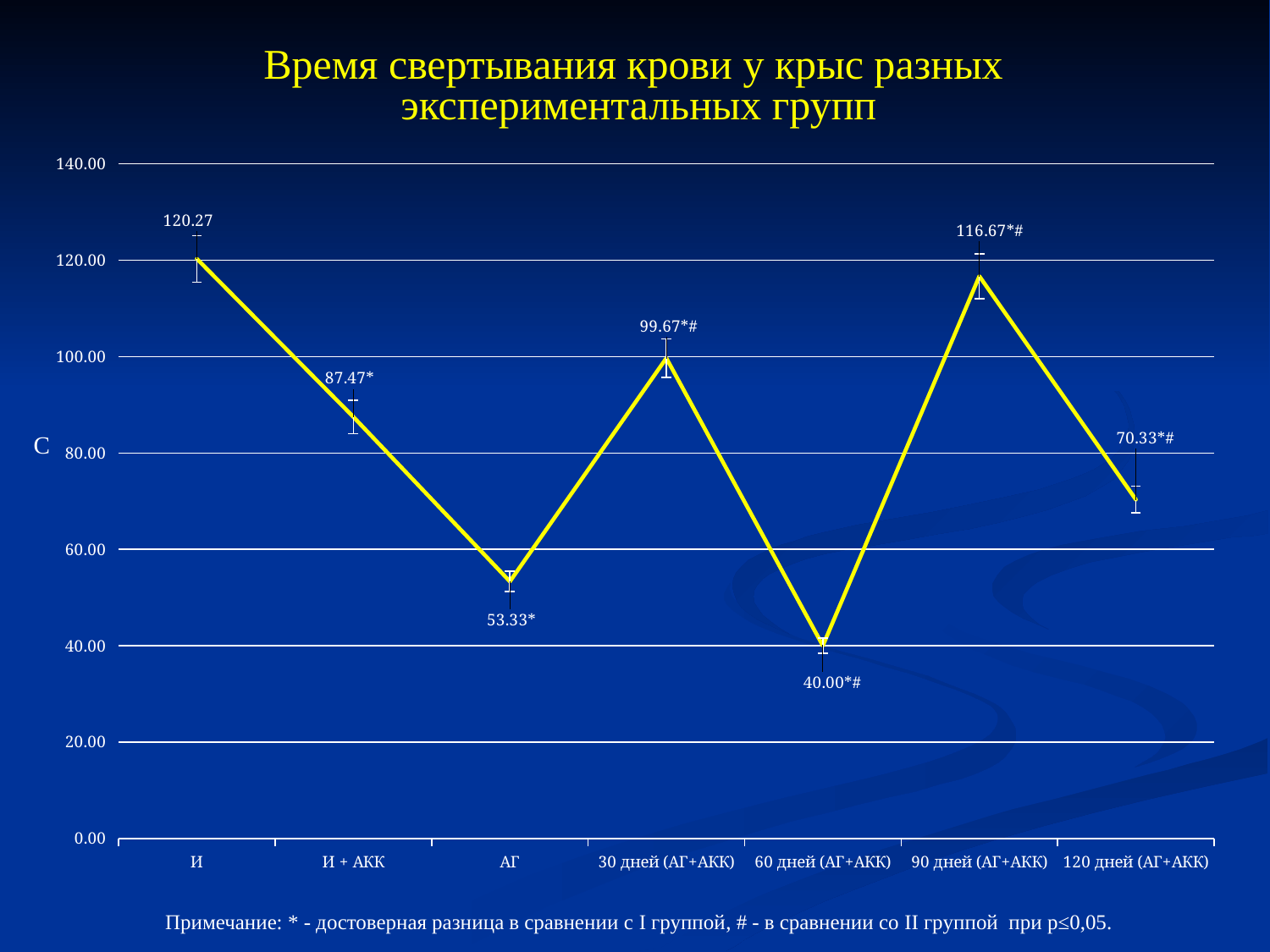
What type of chart is shown on the slide? line chart What is the difference between the values for И and 60 дней (АГ+АКК)? 80.27 What is the difference between the values for 90 дней (АГ+АКК) and 30 дней (АГ+АКК)? 17.00 What is the value for the И group? 120.27 How many groups are plotted on the x axis? 7 Which group has the lowest value? 60 дней (АГ+АКК) Which is larger, the value for И + АКК or the value for 120 дней (АГ+АКК)? И + АКК What is the value for the АГ group? 53.33* What is the value for the 60 дней (АГ+АКК) group? 40.00*# What is the value for the 90 дней (АГ+АКК) group? 116.67*# Which group has the highest value? И What is the title of the chart? Время свертывания крови у крыс разных экспериментальных групп